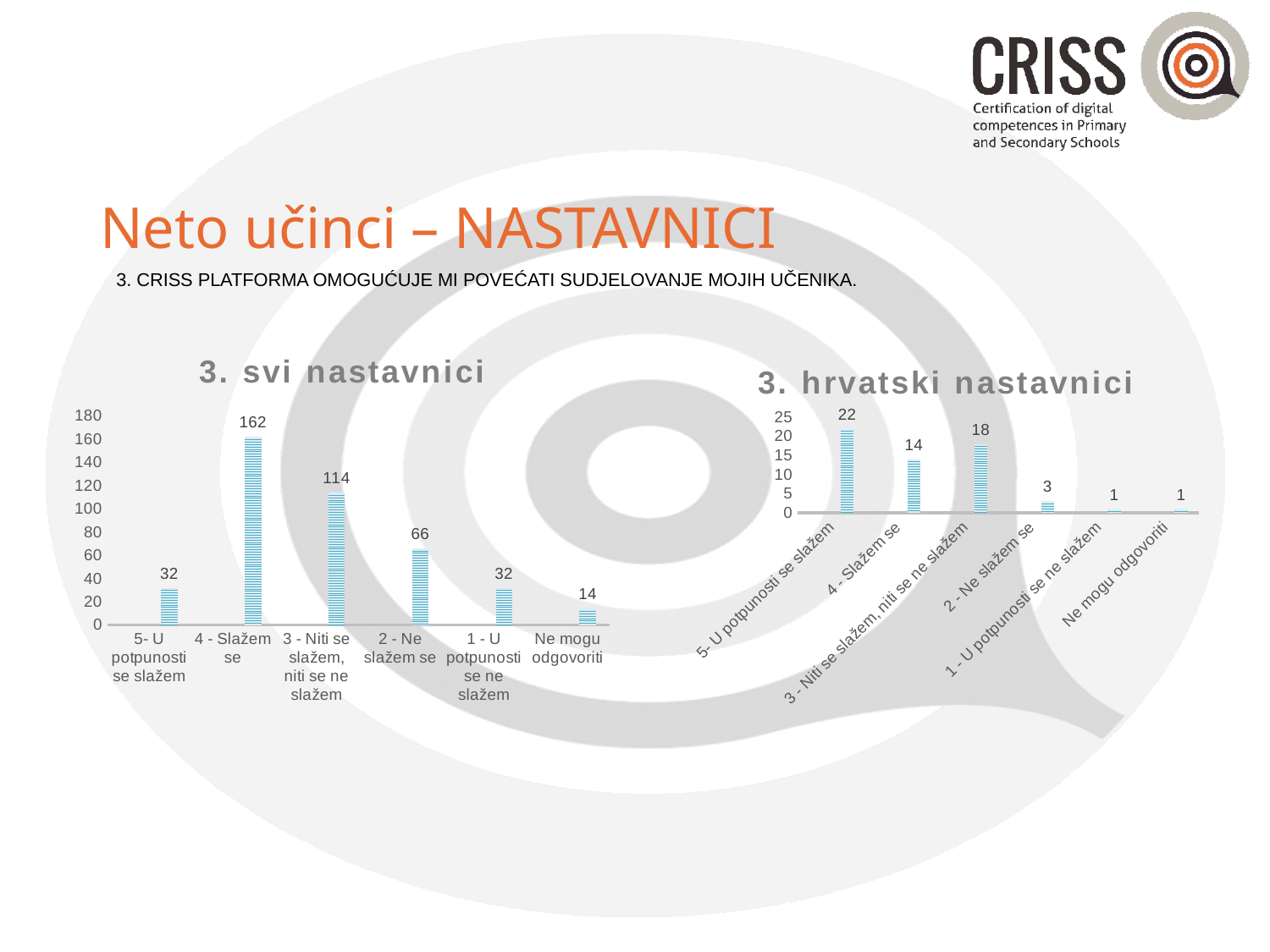
In the chart titled "3. hrvatski nastavnici", which is larger, the value for "4 - Slažem se" or the value for "3 - Niti se slažem, niti se ne slažem"? 3 - Niti se slažem, niti se ne slažem In the chart titled "3. hrvatski nastavnici", what is the difference between the values for "5- U potpunosti se slažem" and "2 - Ne slažem se"? 19 In the chart titled "3. svi nastavnici", what is the value for "2 - Ne slažem se"? 66 In the chart titled "3. svi nastavnici", which category has the lowest value? Ne mogu odgovoriti In the chart titled "3. hrvatski nastavnici", what is the value for "5- U potpunosti se slažem"? 22 In the chart titled "3. svi nastavnici", what is the difference between the values for "4 - Slažem se" and "3 - Niti se slažem, niti se ne slažem"? 48 In the chart titled "3. svi nastavnici", what is the value for "4 - Slažem se"? 162 In the chart titled "3. hrvatski nastavnici", which category has the highest value? 5- U potpunosti se slažem In the chart titled "3. svi nastavnici", which category has the highest value? 4 - Slažem se What kind of chart is the chart titled "3. hrvatski nastavnici"? Bar chart In the chart titled "3. svi nastavnici", is the value for "3 - Niti se slažem, niti se ne slažem" greater or less than 100? greater In the chart titled "3. svi nastavnici", how many categories are shown on the x axis? 6